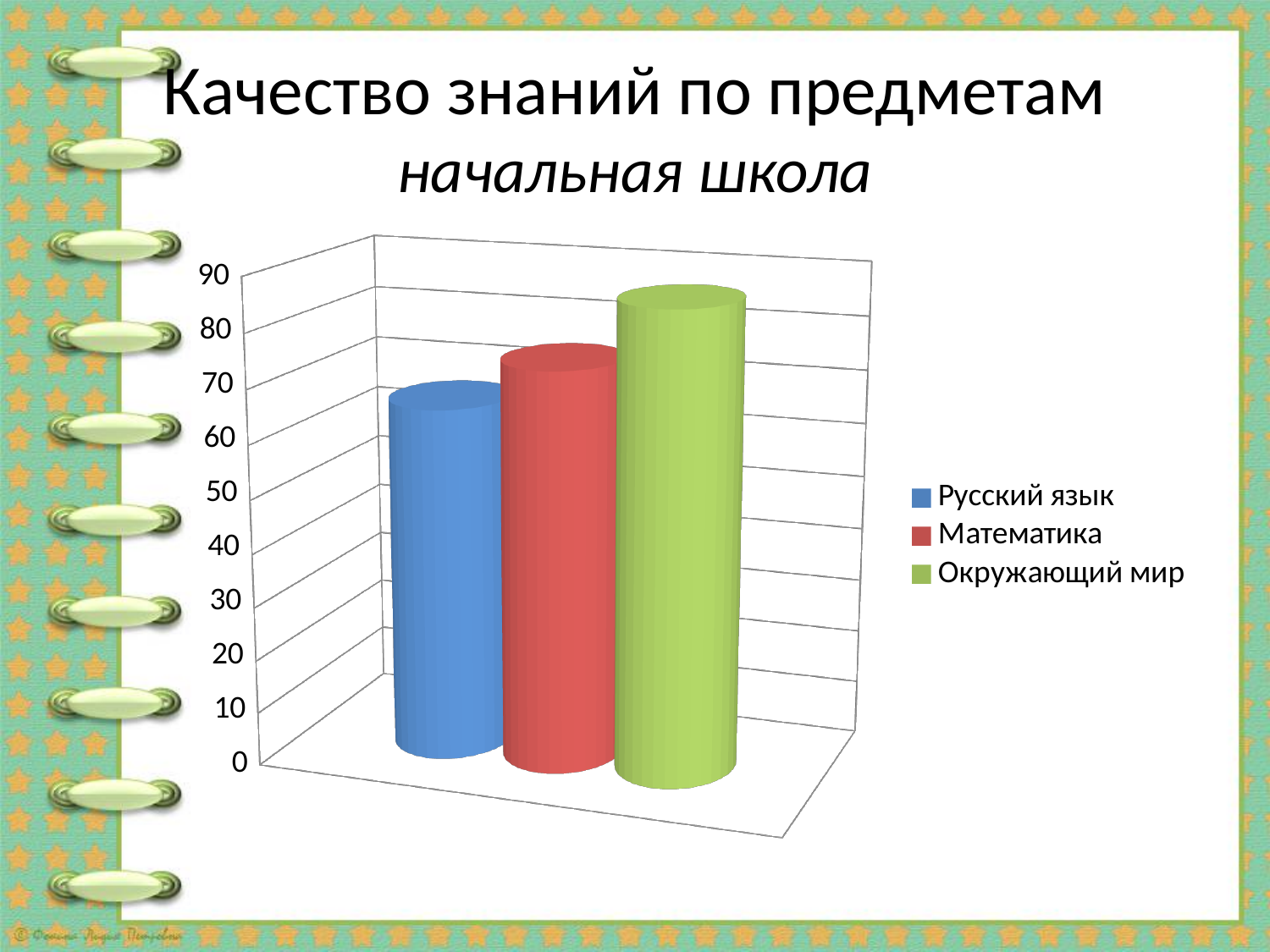
Which series has the highest value? Окружающий мир Which series has the lowest value? Русский язык Is the value for Русский язык greater or less than 50? greater Is the value for Окружающий мир greater or less than 70? greater How many bars are plotted in the chart? 3 Which is larger, the value for Окружающий мир or the value for Математика? Окружающий мир What colour is the bar for Математика? red What kind of chart is shown on the slide? bar chart Is the value for Математика greater or less than 60? greater Which is larger, the value for Математика or the value for Русский язык? Математика What is the title of the slide containing the chart? Качество знаний по предметам начальная школа How many series does the legend list? 3